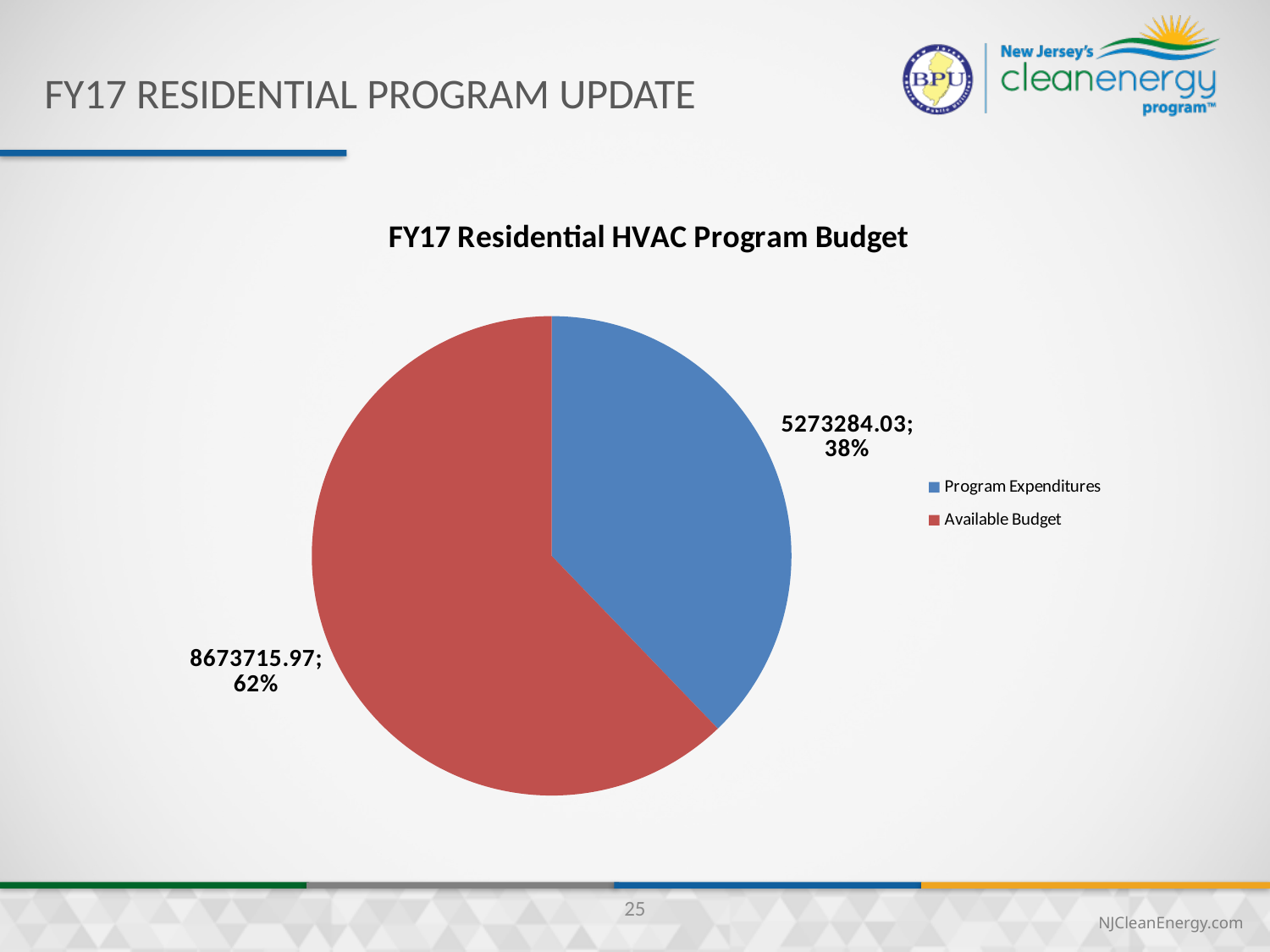
What share of the pie is Available Budget? 62% Which slice is the largest? Available Budget How many slices does the pie chart have? 2 What is the difference between Available Budget and Program Expenditures? 3400431.94 Which colour represents Available Budget in the legend? red What is the title of the chart? FY17 Residential HVAC Program Budget What is the value for Program Expenditures? 5273284.03 What type of chart is shown on the slide? pie chart Which slice is the smallest? Program Expenditures Which is larger, Program Expenditures or Available Budget? Available Budget What is the value for Available Budget? 8673715.97 What share of the pie is Program Expenditures? 38%